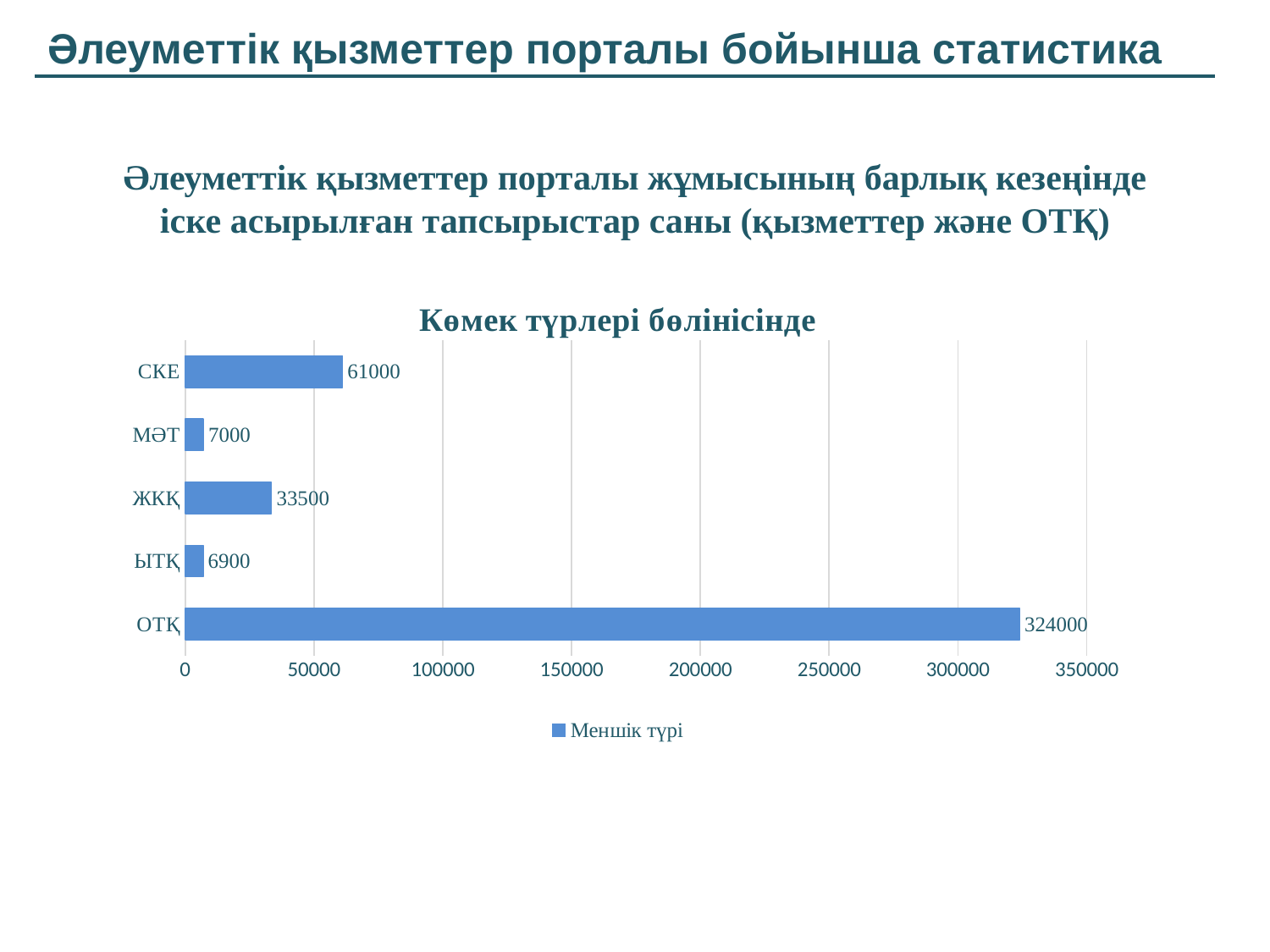
What is the value for ОТҚ? 324000 What kind of chart is shown? bar chart Which category has the highest value? ОТҚ Is the value for ОТҚ greater or less than 300000? greater What is the value for СКЕ? 61000 What is the difference between the values for СКЕ and ЖКҚ? 27500 How many series does the legend list? 1 How many categories are shown in the chart? 5 Which category has the lowest value? ЫТҚ What is the value for ЖКҚ? 33500 What is the title of the chart? Көмек түрлері бөлінісінде Which is larger, the value for МӘТ or the value for ЫТҚ? МӘТ